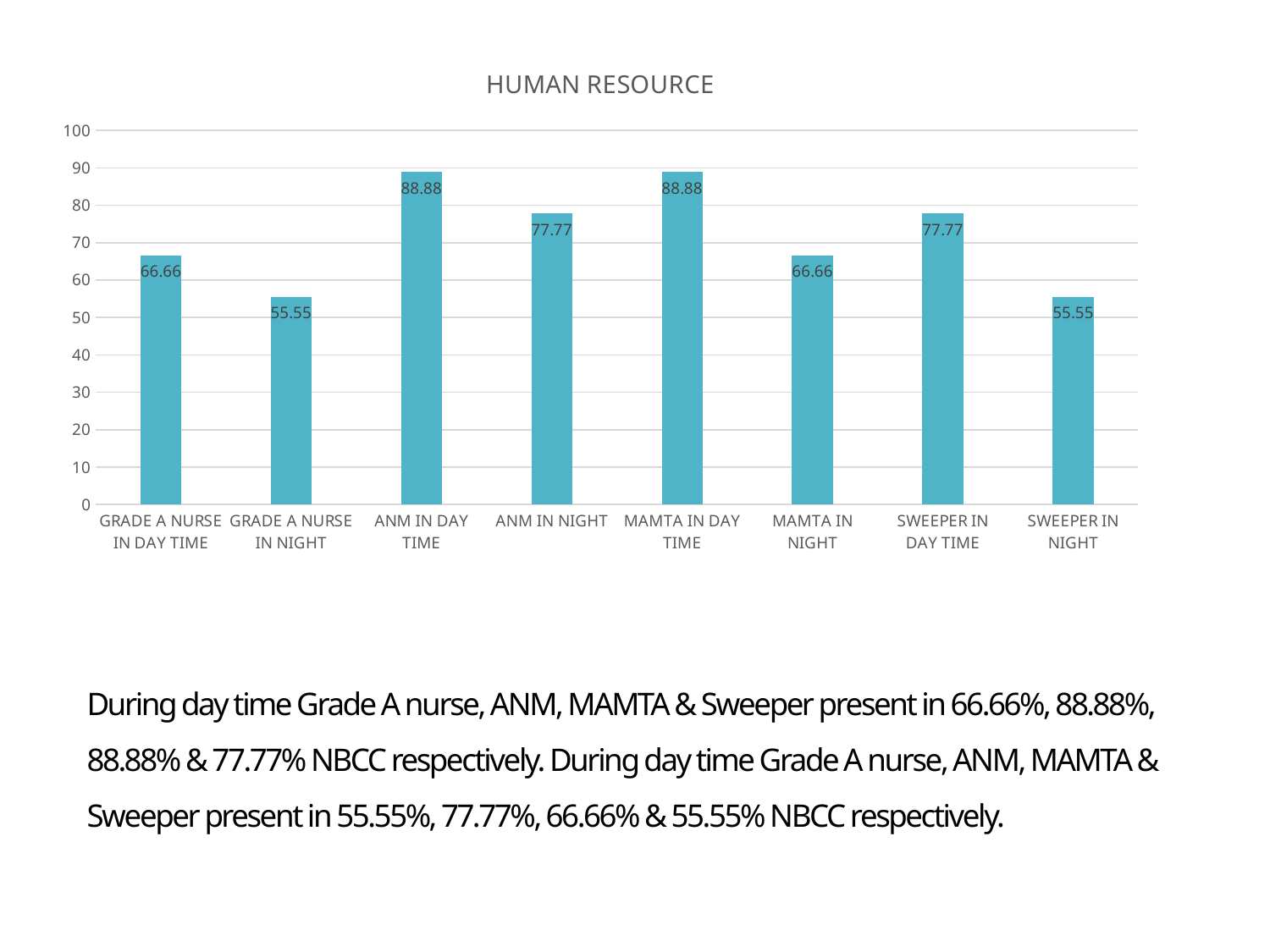
What is the title of the chart? HUMAN RESOURCE What is the value for ANM IN DAY TIME? 88.88 What is the value for SWEEPER IN NIGHT? 55.55 How many categories are shown on the x axis? 8 What is the difference between the values for GRADE A NURSE IN DAY TIME and GRADE A NURSE IN NIGHT? 11.11 Which is larger, the value for SWEEPER IN DAY TIME or the value for SWEEPER IN NIGHT? SWEEPER IN DAY TIME What is the difference between the values for ANM IN DAY TIME and ANM IN NIGHT? 11.11 What is the value for MAMTA IN NIGHT? 66.66 What kind of chart is shown on the slide? bar chart Which category has the lowest value, GRADE A NURSE IN DAY TIME or GRADE A NURSE IN NIGHT? GRADE A NURSE IN NIGHT Is the value for MAMTA IN DAY TIME greater or less than 80? greater Is the value for GRADE A NURSE IN NIGHT greater or less than 60? less